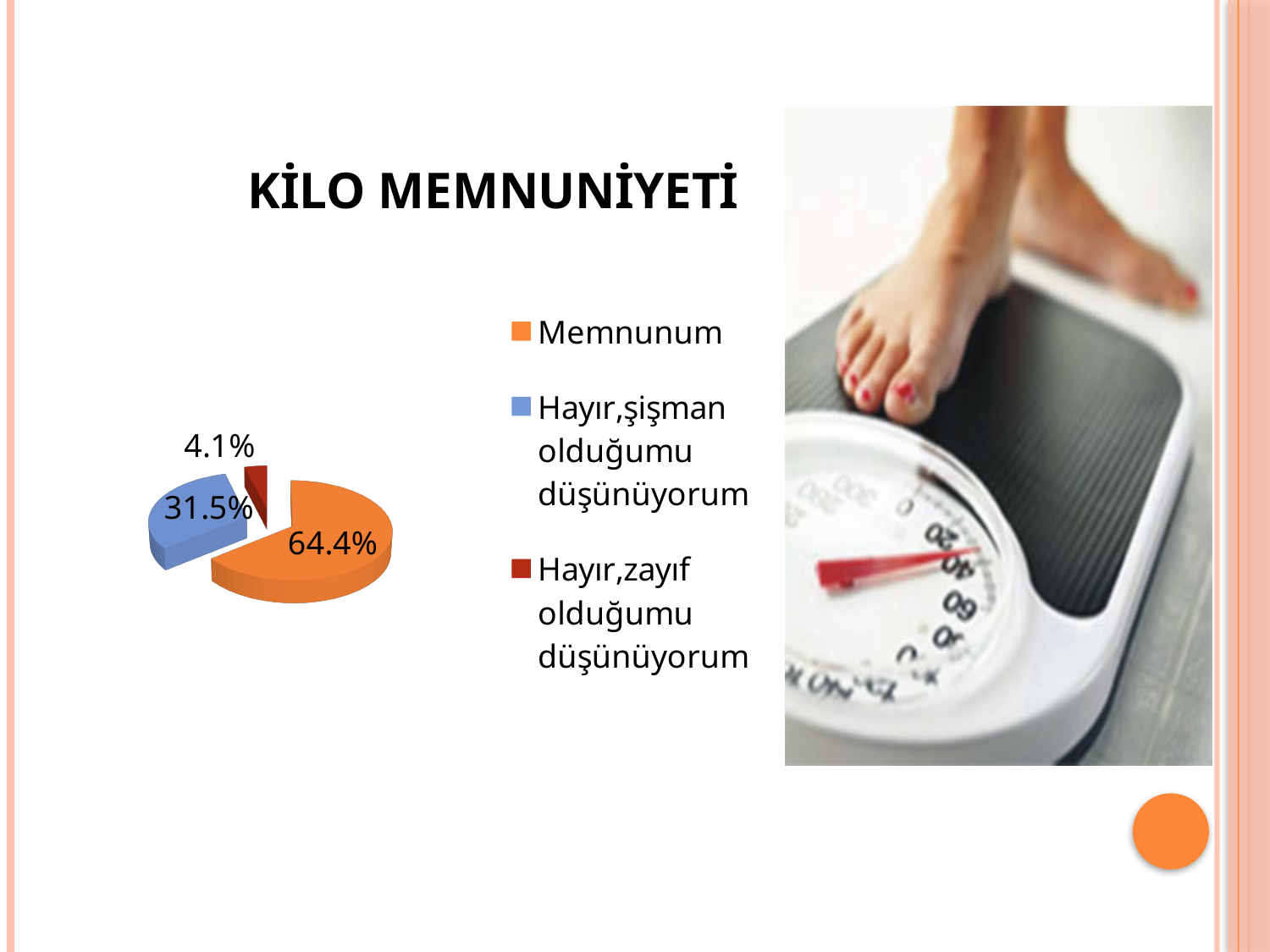
Which is larger: the share for "Hayır,şişman olduğumu düşünüyorum" or the share for "Hayır,zayıf olduğumu düşünüyorum"? Hayır,şişman olduğumu düşünüyorum What is the title of the slide containing the pie chart? KİLO MEMNUNİYETİ Which category has the largest share of the pie? Memnunum What percentage of the pie is labelled "Memnunum"? 64.4% What colour is the "Memnunum" slice in the pie chart? Orange How many slices does the pie chart have? 3 How many entries does the legend list? 3 Which category has the smallest share of the pie? Hayır,zayıf olduğumu düşünüyorum What kind of chart is shown on the slide? Pie chart What percentage of the pie is labelled "Hayır,zayıf olduğumu düşünüyorum"? 4.1% What percentage of the pie is labelled "Hayır,şişman olduğumu düşünüyorum"? 31.5% What is the difference in percentage points between "Memnunum" and "Hayır,şişman olduğumu düşünüyorum"? 32.9